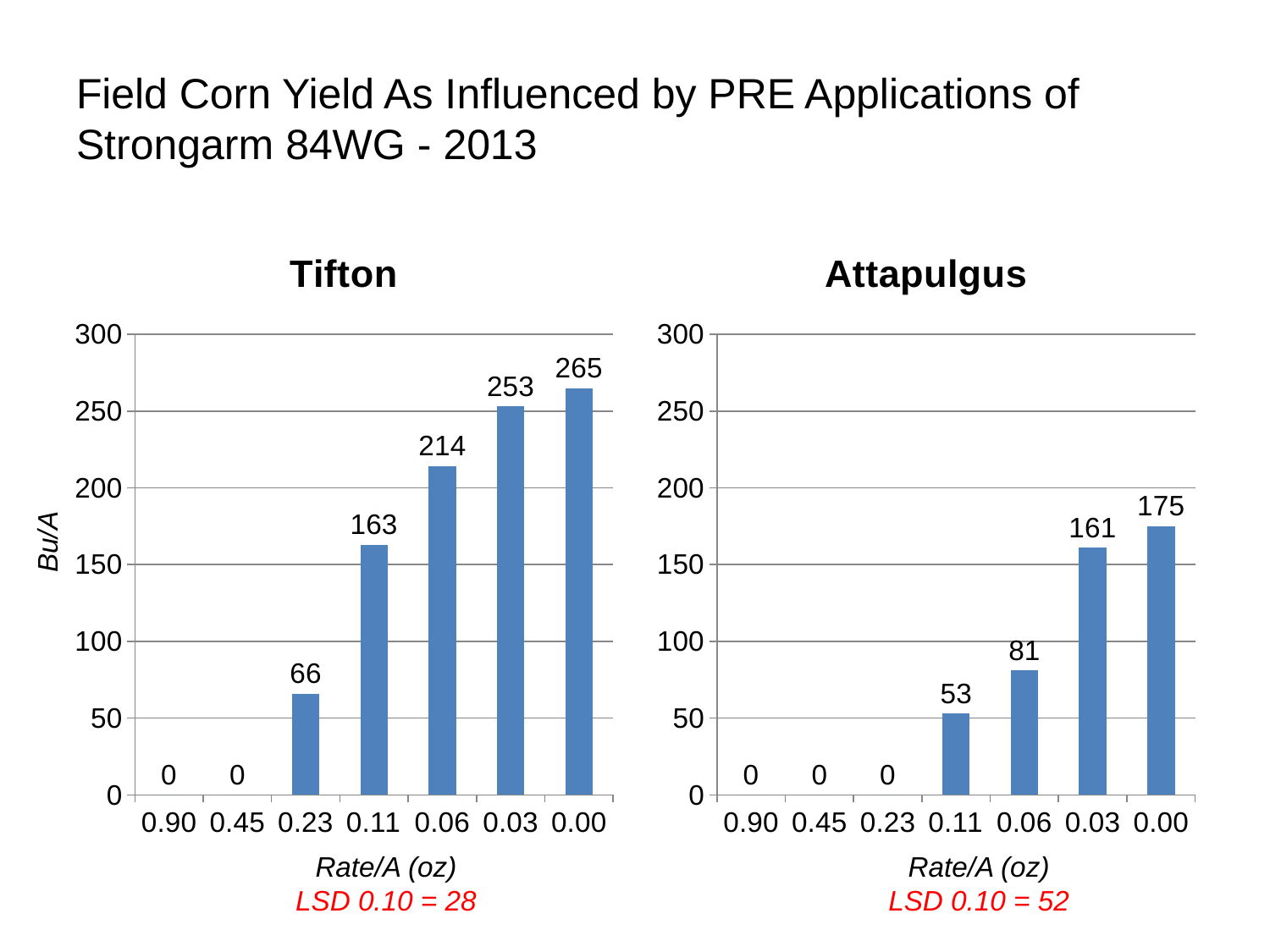
What is the y-axis label on the Tifton chart? Bu/A In the Attapulgus chart, what is the difference in yield between the 0.03 and 0.11 oz rates? 108 In the Attapulgus chart, how many rates have a yield of 0? 3 What type of chart is used for the Tifton data? bar chart In the Tifton chart, what is the yield at the 0.11 oz rate? 163 In the Attapulgus chart, what is the yield at the 0.06 oz rate? 81 In the Tifton chart, what is the difference in yield between the 0.00 and 0.03 oz rates? 12 In the Tifton chart, is the yield at the 0.06 oz rate greater or less than 200? greater Which chart shows the larger yield at the 0.00 oz rate, Tifton or Attapulgus? Tifton How many rate categories are shown on the x axis of the Attapulgus chart? 7 In the Tifton chart, which rate has the highest yield? 0.00 In the Attapulgus chart, which rate has the highest yield? 0.00